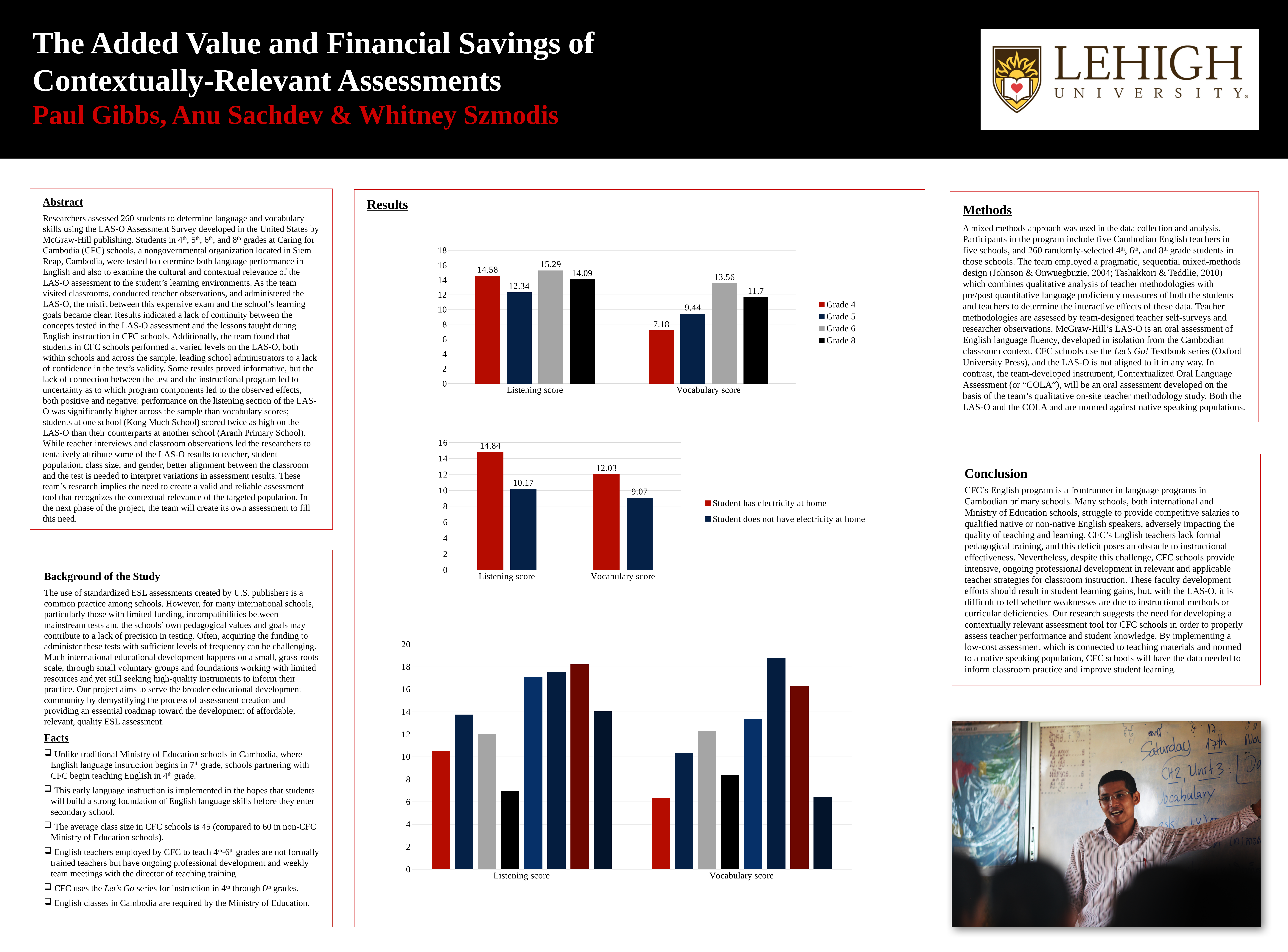
In the bottom chart, how many bars are shown in the Listening score group? 8 How many categories are shown on the x axis of the middle chart (electricity at home)? 2 In the top chart (by grade), what is the Listening score for Grade 6? 15.29 In the top chart (by grade), what is the difference between the Grade 6 and Grade 4 Vocabulary scores? 6.38 What kind of chart is the middle chart (electricity at home)? Bar chart In the top chart (by grade), which is larger: the Listening score for Grade 5 or for Grade 8? Grade 8 In the top chart (by grade), what is the Vocabulary score for Grade 4? 7.18 In the top chart (by grade), which grade has the highest Listening score? Grade 6 In the middle chart (electricity at home), what is the difference in Listening score between students with and without electricity at home? 4.67 In the top chart (by grade), which grade has the lowest Vocabulary score? Grade 4 In the middle chart (electricity at home), what is the Vocabulary score for students who do not have electricity at home? 9.07 How many series does the legend of the top chart (by grade) list? 4